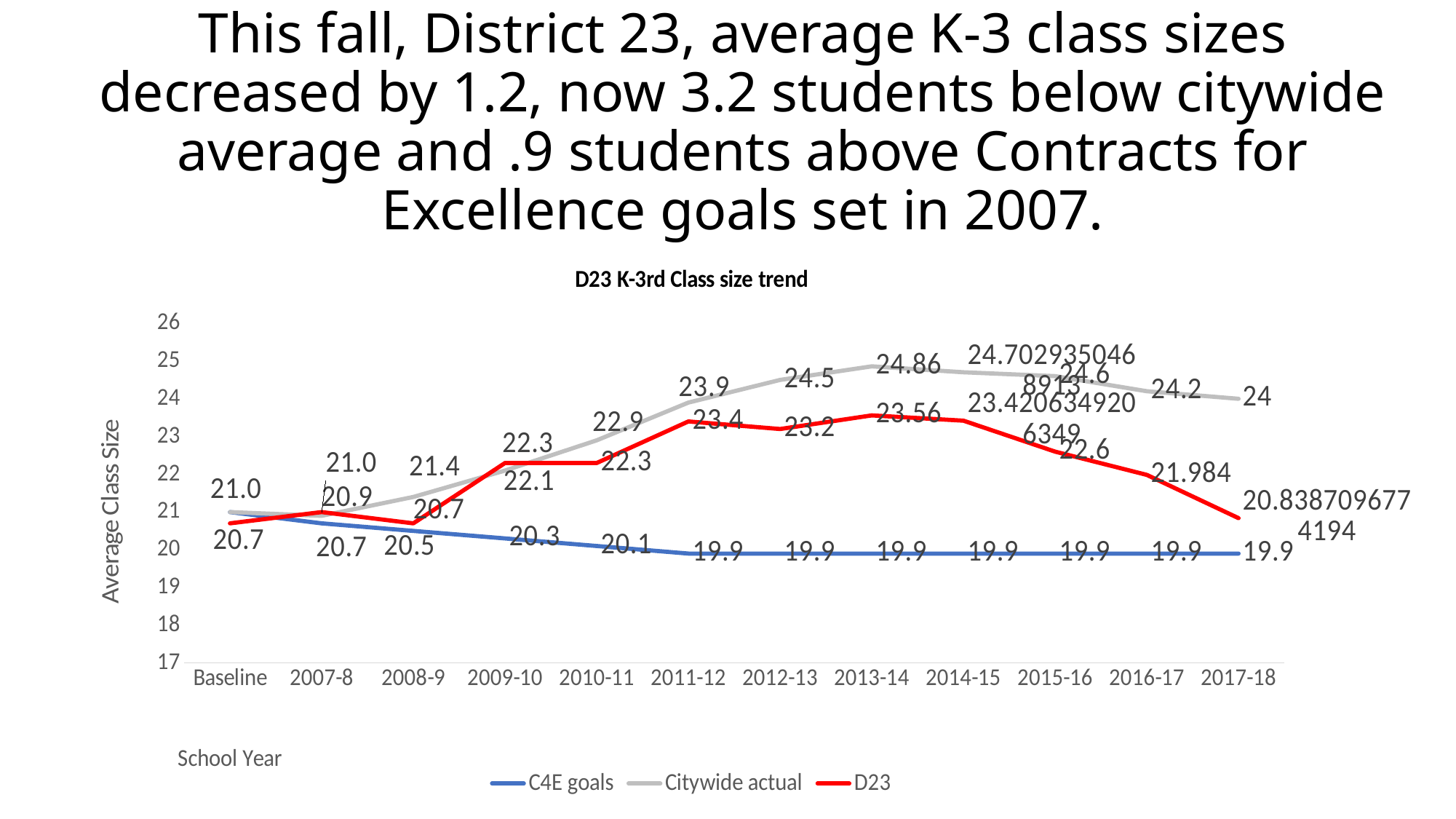
What is the D23 value for 2011-12? 23.4 How many series does the legend of the D23 K-3rd Class size trend chart list? 3 What kind of chart is shown on the slide? Line chart What is the label on the vertical axis of the chart? Average Class Size In 2017-18, which is larger: the Citywide actual value or the C4E goals value? Citywide actual What is the C4E goals value for 2017-18? 19.9 What is the D23 value for 2016-17? 21.984 How many school-year categories are shown on the x axis of the chart? 12 What is the difference between the Citywide actual and D23 values in 2013-14? 1.3 What is the Citywide actual value for 2013-14? 24.86 In which school year does the Citywide actual series reach its highest value? 2013-14 Does the D23 series rise or fall from 2013-14 to 2017-18? Fall